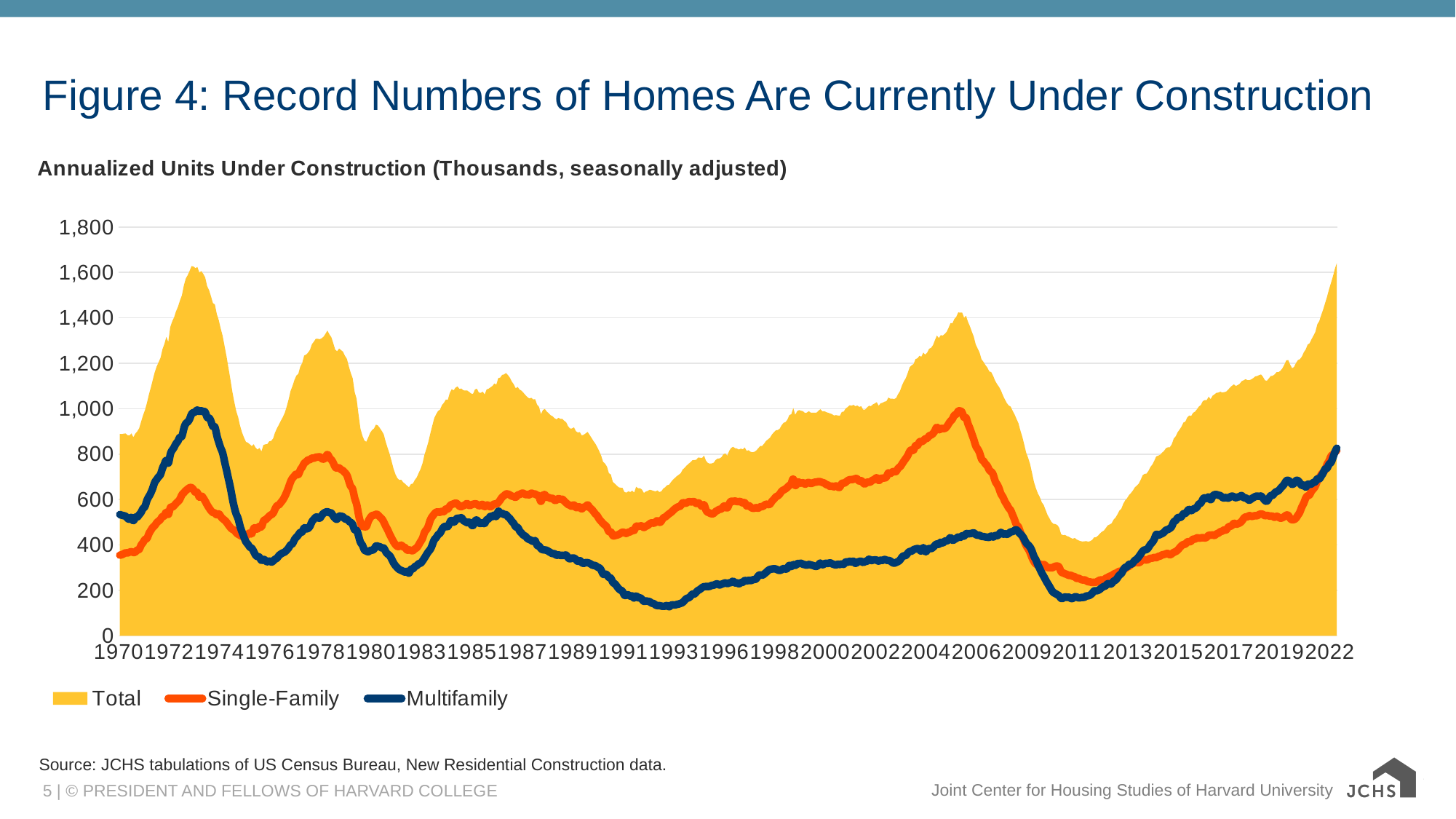
Does the Total series rise or fall from 2011 to 2022? rise What kind of chart is this? area and line chart Is the peak value for Single-Family around 2005 greater or less than 800? greater What is the title of the chart? Annualized Units Under Construction (Thousands, seasonally adjusted) Does the Multifamily series rise or fall from 1986 to 1993? fall Which series is shown as a shaded area rather than a line? Total Around 2005, which is higher, Single-Family or Multifamily? Single-Family Around 1972, which is higher, Single-Family or Multifamily? Multifamily Is the peak value for Total around 1972 greater or less than 1,400? greater Is the value for Total at the end of the series in 2022 greater or less than 1,400? greater How many series does the legend list? 3